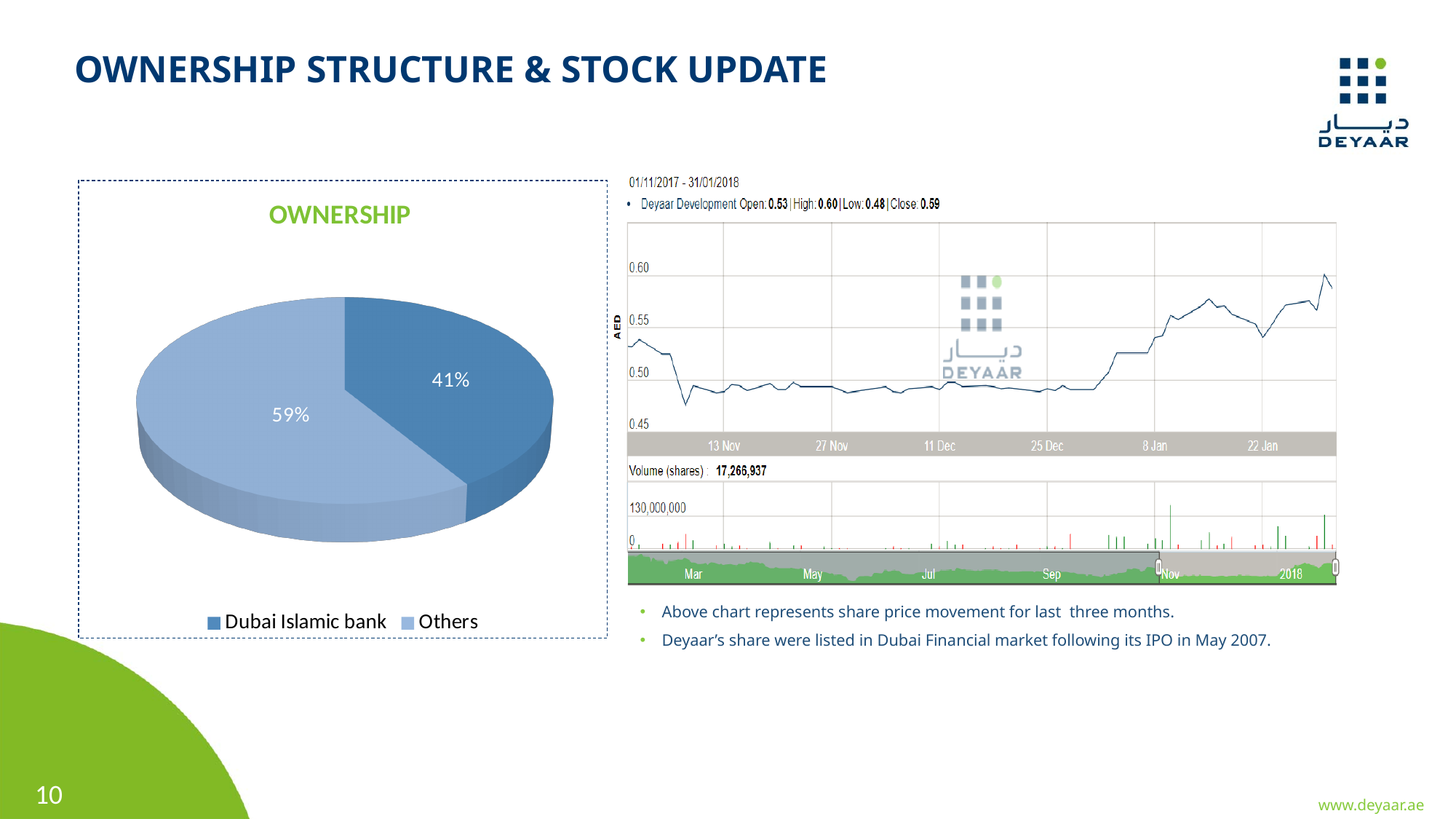
What kind of chart is the OWNERSHIP chart on the left of the slide? Pie chart In the OWNERSHIP pie chart, what share is labelled Others? 59% In the share price chart on the right, what is the High value printed for Deyaar Development? 0.60 In the share price chart on the right, what is the Close value printed for Deyaar Development? 0.59 In the OWNERSHIP pie chart, what is the difference in percentage points between Others and Dubai Islamic bank? 18 How many entries does the legend of the OWNERSHIP chart list? 2 In the OWNERSHIP pie chart, what share is held by Dubai Islamic bank? 41% How many slices does the OWNERSHIP pie chart have? 2 In the OWNERSHIP pie chart, which is larger: Dubai Islamic bank or Others? Others In the share price chart on the right, does the share price overall rise or fall from November 2017 to January 2018? Rise In the OWNERSHIP pie chart, which slice is the largest? Others In the OWNERSHIP pie chart, which slice is the smallest? Dubai Islamic bank